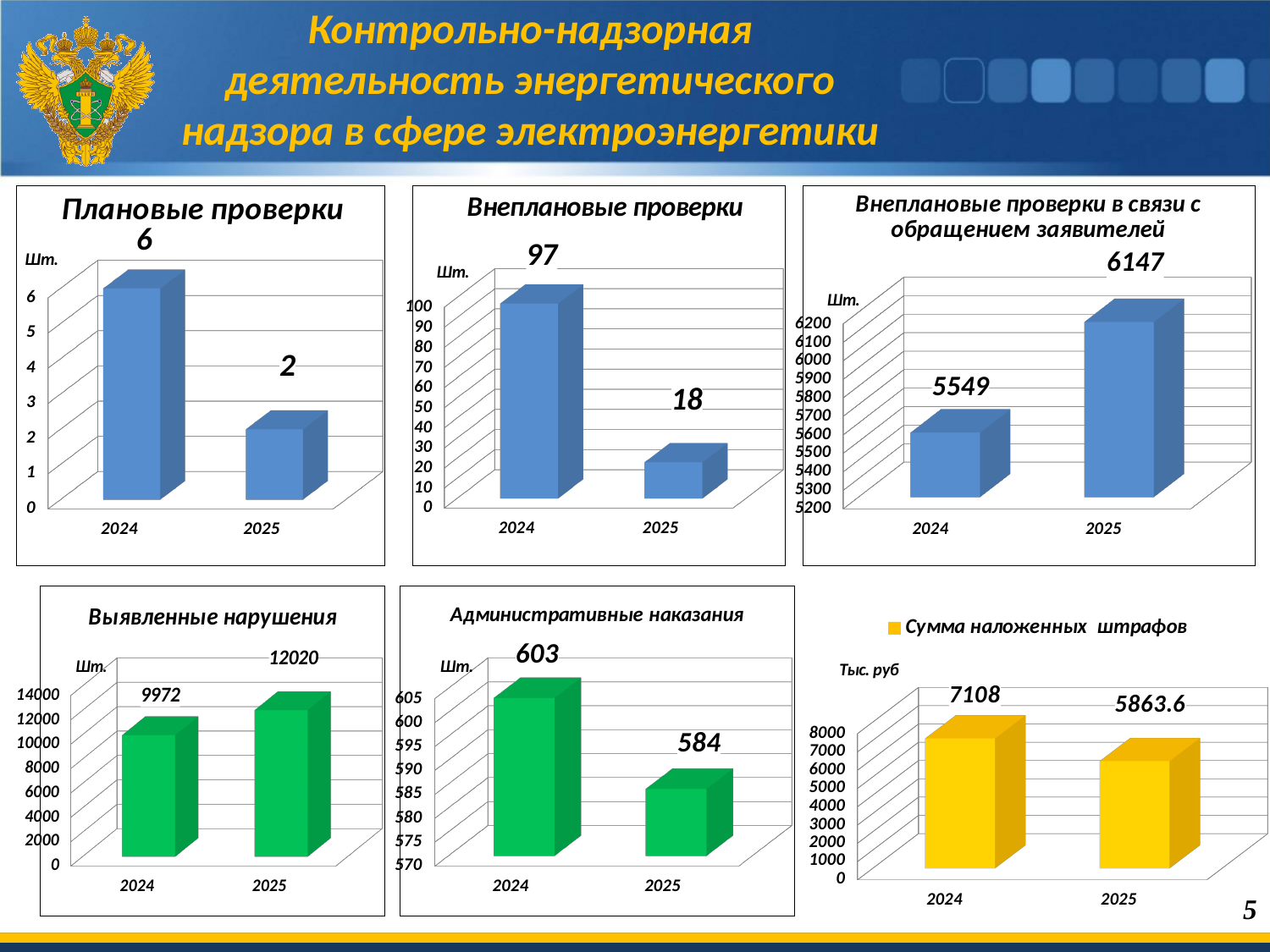
In the 'Внеплановые проверки' chart, what is the value for 2025? 18 In the 'Выявленные нарушения' chart, do the values rise or fall from 2024 to 2025? rise In the 'Внеплановые проверки в связи с обращением заявителей' chart, which year has the higher value? 2025 In the 'Сумма наложенных штрафов' chart, what is the value for 2025? 5863.6 In the 'Плановые проверки' chart, what is the value for 2024? 6 In the 'Административные наказания' chart, what is the value for 2024? 603 In the 'Внеплановые проверки в связи с обращением заявителей' chart, what is the value for 2024? 5549 In the 'Выявленные нарушения' chart, what is the value for 2025? 12020 In the 'Сумма наложенных штрафов' chart, which year has the lower value? 2025 In the 'Административные наказания' chart, what is the difference between the 2024 and 2025 values? 19 What type of chart is the 'Плановые проверки' chart? bar chart In the 'Внеплановые проверки' chart, what is the difference between the 2024 and 2025 values? 79